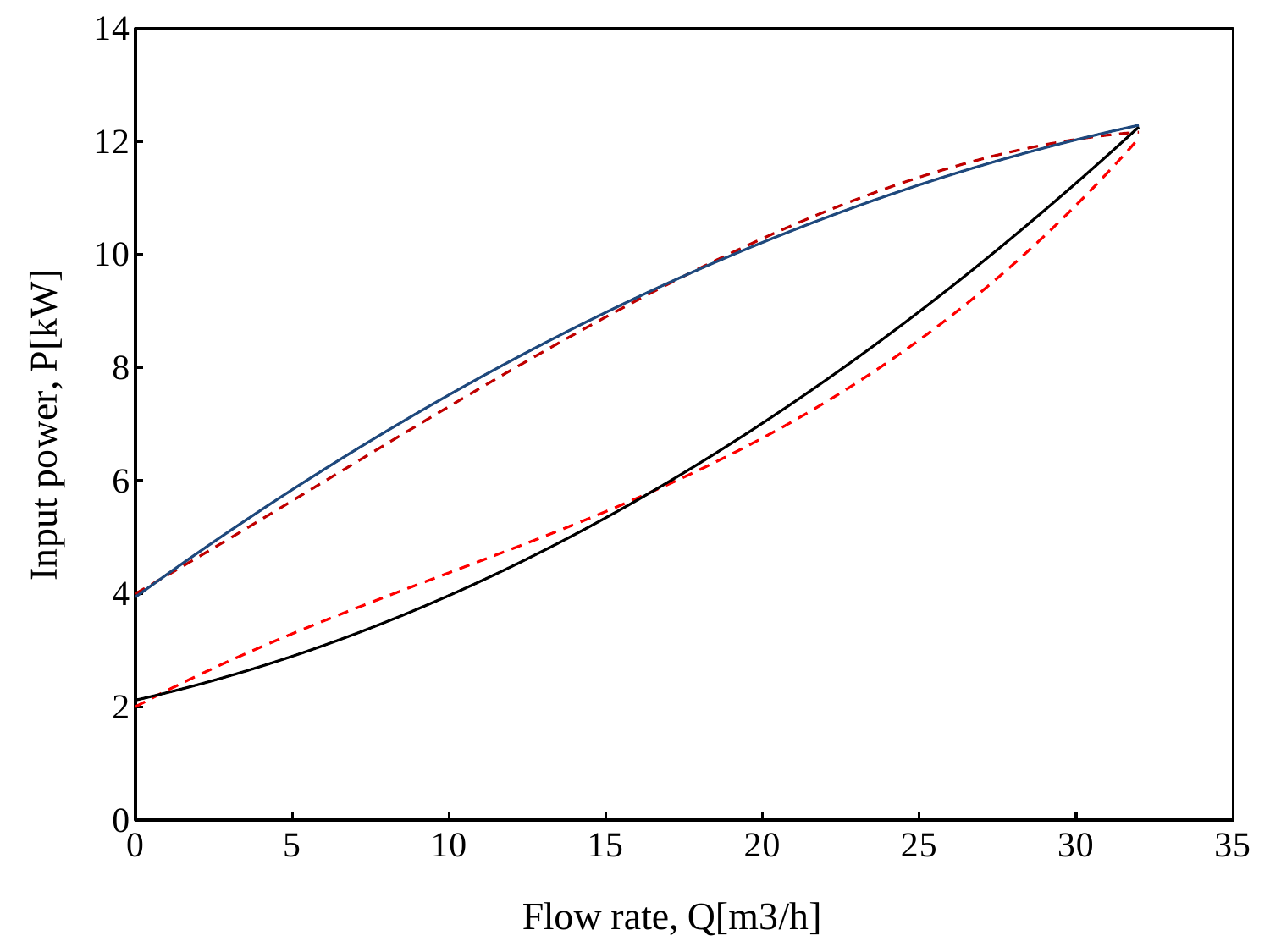
At a flow rate of 5, is the value of the blue solid line greater or less than 4? greater What is the label of the x axis? Flow rate, Q[m3/h] At a flow rate of 0, which line has the higher input power, the blue solid line or the black solid line? blue solid line At a flow rate of 10, is the value of the blue solid line greater or less than 6? greater Does the blue solid line rise or fall as flow rate increases? rise At a flow rate of 10, which line has the higher input power, the blue solid line or the black solid line? blue solid line What kind of chart is shown on the slide? line chart At a flow rate of 20, is the value of the black solid line greater or less than 6? greater What is the label of the y axis? Input power, P[kW] How many lines are plotted on the chart? 4 Does the black solid line rise or fall as flow rate increases? rise